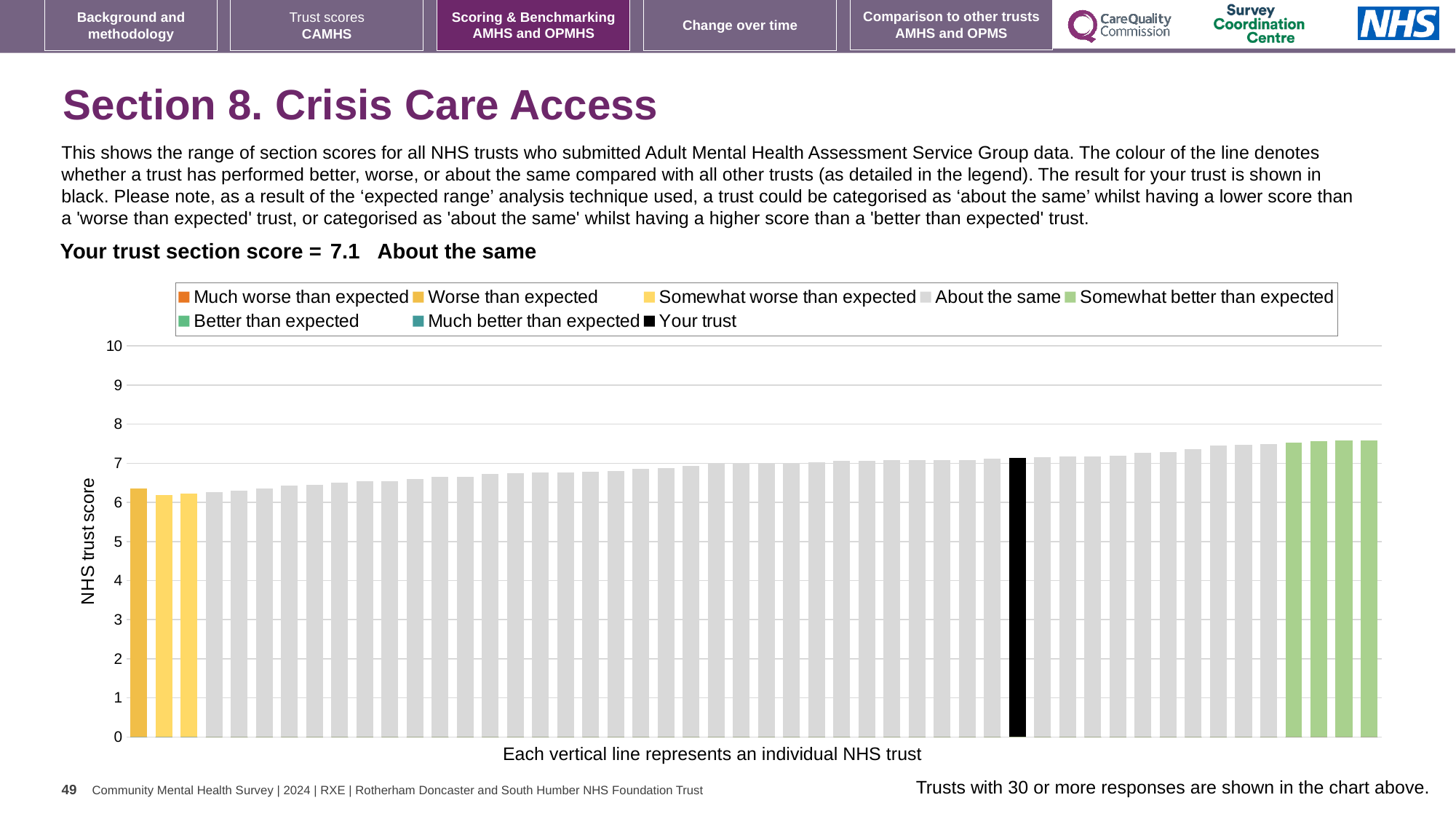
Which legend category do the highest bars in the chart belong to? Somewhat better than expected Do the bar values rise or fall from left to right along the x axis? rise How many bars are coloured as 'Somewhat better than expected'? 4 How many bars are coloured as 'Somewhat worse than expected'? 2 Is the value of the leftmost bar greater or less than 7? less How many entries does the chart legend list? 8 What kind of chart is shown on the slide? bar chart Which category is your trust placed in for this section? About the same Is the value of the black 'Your trust' bar greater or less than 7? greater Is the value of the rightmost bar greater or less than 8? less What is the section score for your trust shown on the slide? 7.1 What is the label on the vertical axis of the chart? NHS trust score